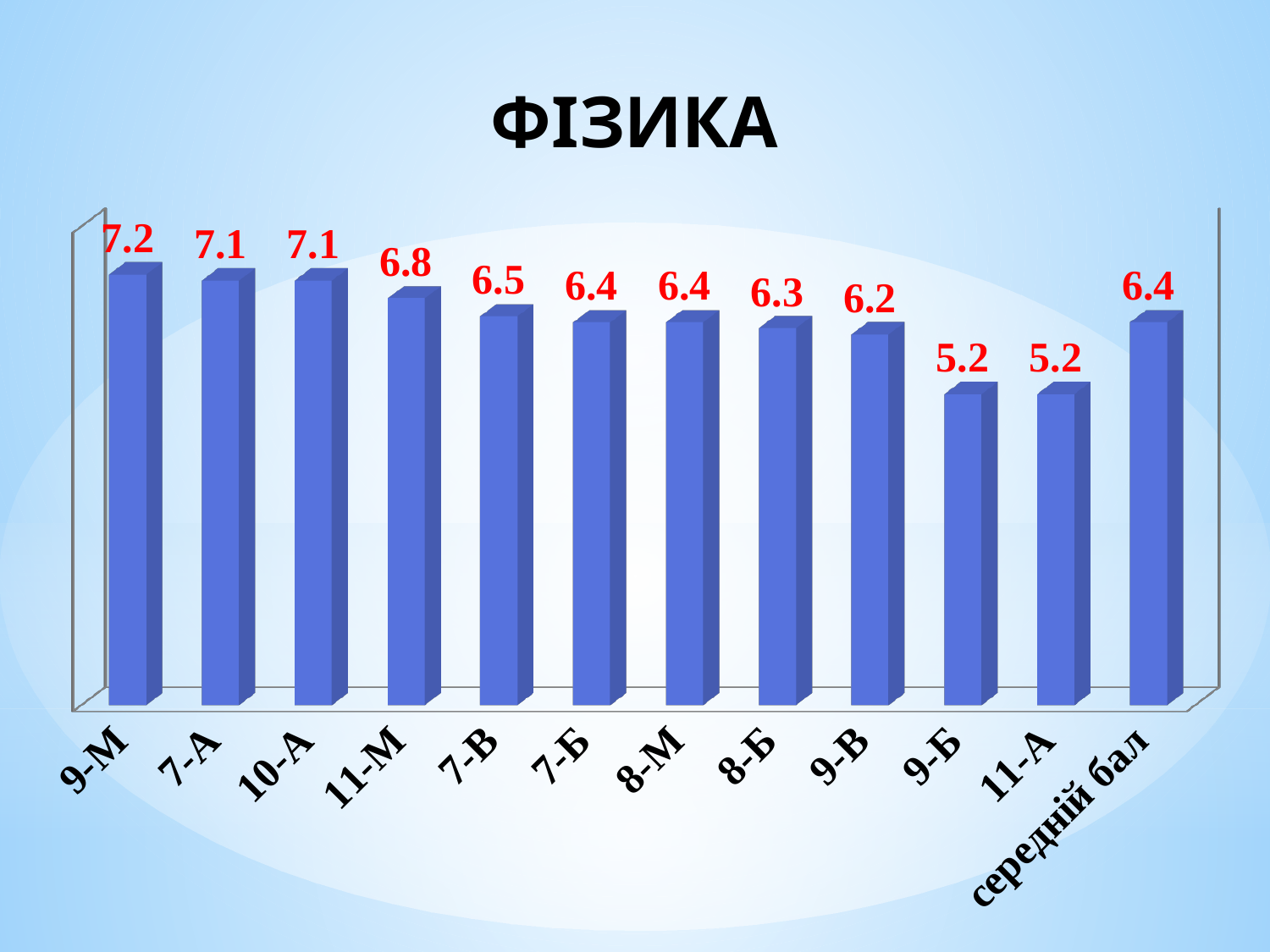
What is the value for 9-М? 7.2 What kind of chart is shown? bar chart What is the value for середній бал? 6.4 What is the value for 11-М? 6.8 Which category has the highest value? 9-М What is the difference between the values for 7-А and 7-В? 0.6 What is the title of the chart? ФІЗИКА How many categories are shown on the x axis? 12 What is the difference between the values for 9-М and 9-Б? 2.0 What is the value for 9-В? 6.2 Which is larger, the value for 10-А or the value for 8-Б? 10-А Which is larger, the value for 11-А or the value for 7-Б? 7-Б